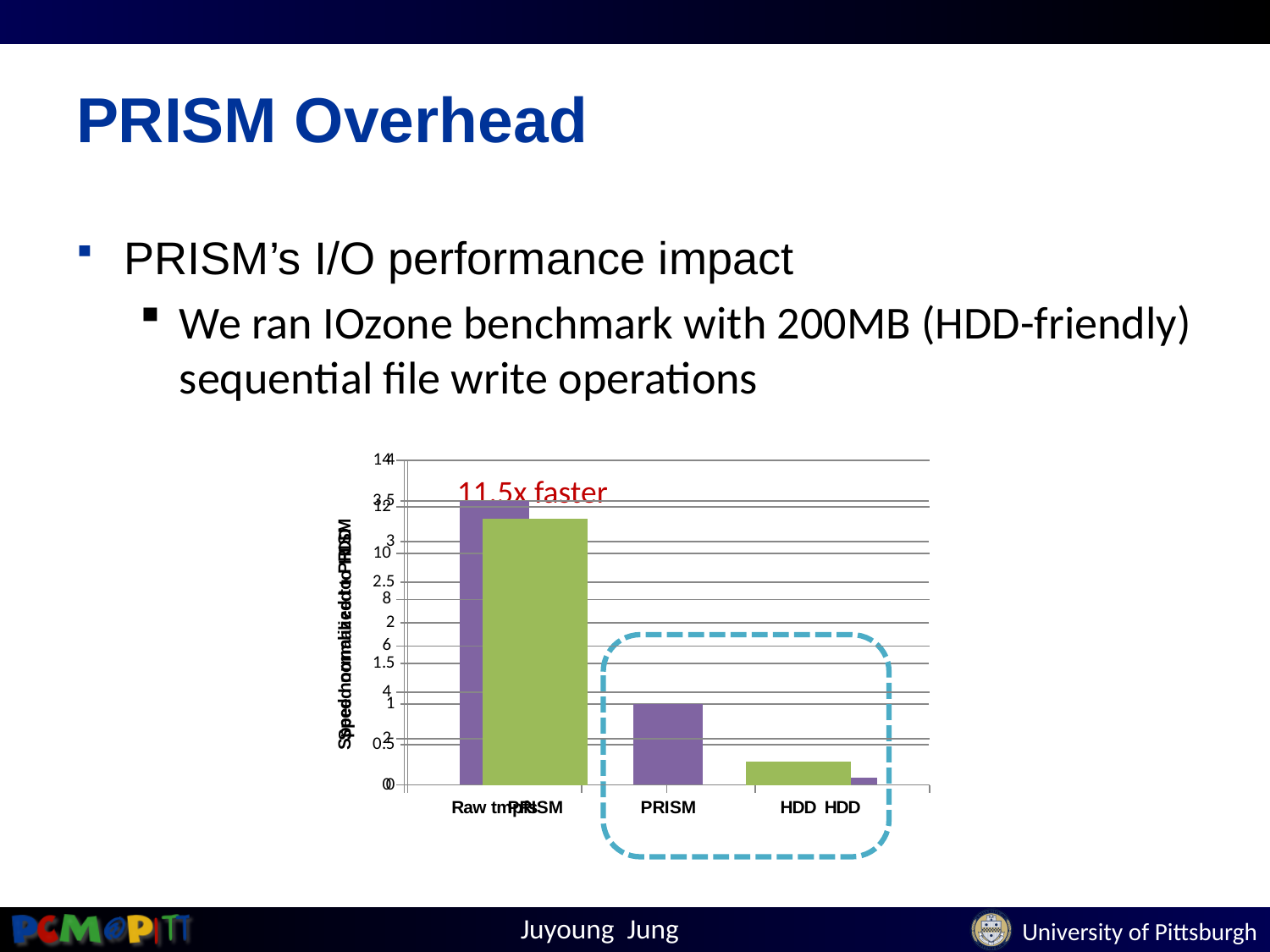
Which is taller, the purple bar for Raw tmpfs or the purple bar for PRISM? Raw tmpfs What annotation text is written in red above the tallest bars? 11.5x faster Do the purple bars rise or fall moving from Raw tmpfs to HDD along the x axis? fall Which is taller, the green bar for PRISM or the green bar for HDD? PRISM Which two categories are enclosed by the dashed blue rounded box? PRISM and HDD Which category has the tallest purple bar? Raw tmpfs What kind of chart is shown on the slide? bar chart How many purple bars are plotted on the chart? 3 Which category has the shortest purple bar? HDD How many green bars are plotted on the chart? 2